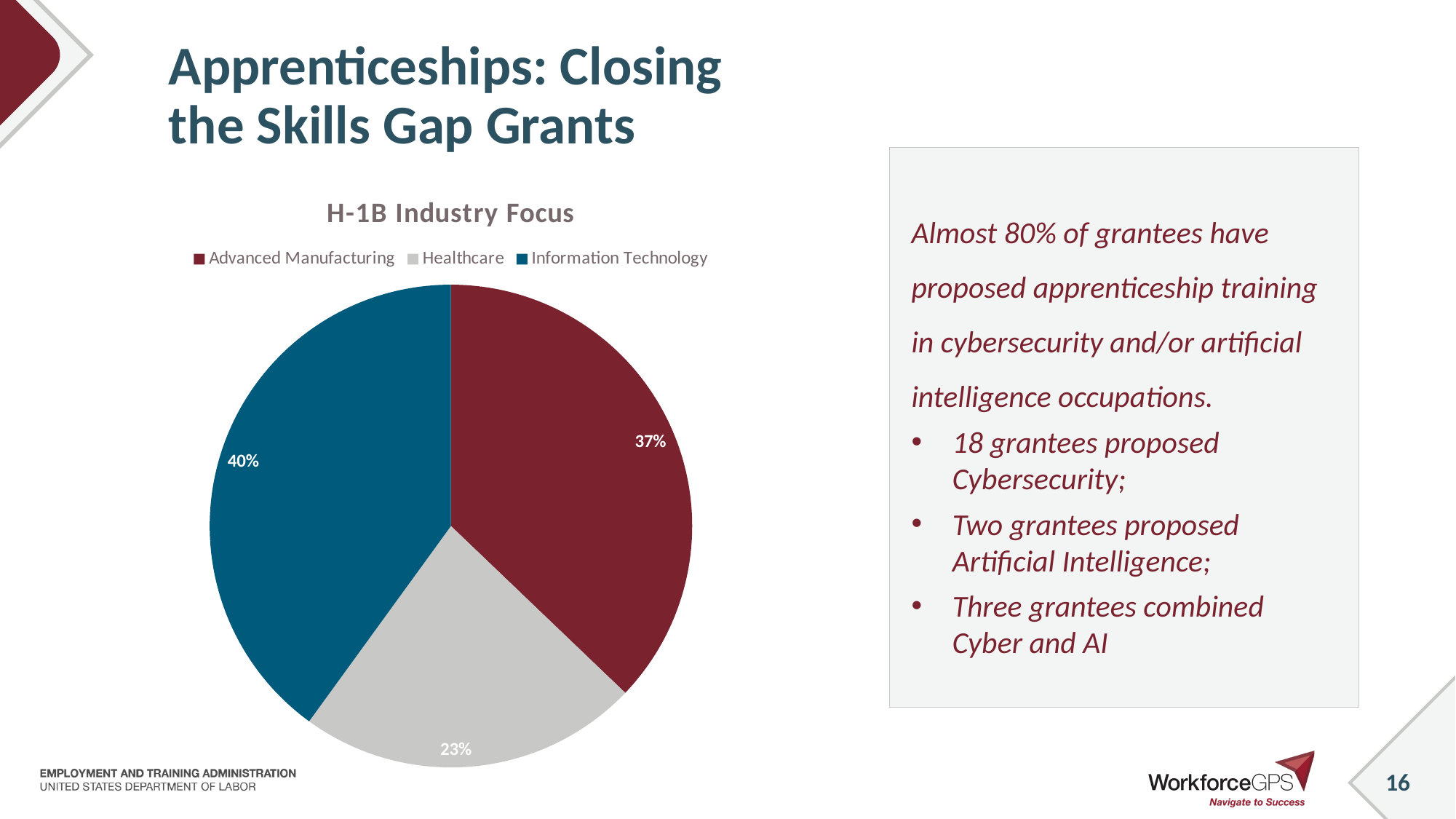
What is the title of the chart? H-1B Industry Focus What kind of chart is shown on the slide? Pie chart Which industry has the smallest slice of the pie? Healthcare Which is larger, the Advanced Manufacturing slice or the Healthcare slice? Advanced Manufacturing What is the difference in percentage points between the Advanced Manufacturing and Healthcare slices? 14 How many industries are shown in the pie chart? 3 Which industry is shown in blue in the pie chart? Information Technology What share of the pie does Advanced Manufacturing hold? 37% What share of the pie does Information Technology hold? 40% Which industry has the largest slice of the pie? Information Technology What is the difference in percentage points between the Information Technology and Healthcare slices? 17 What share of the pie does Healthcare hold? 23%